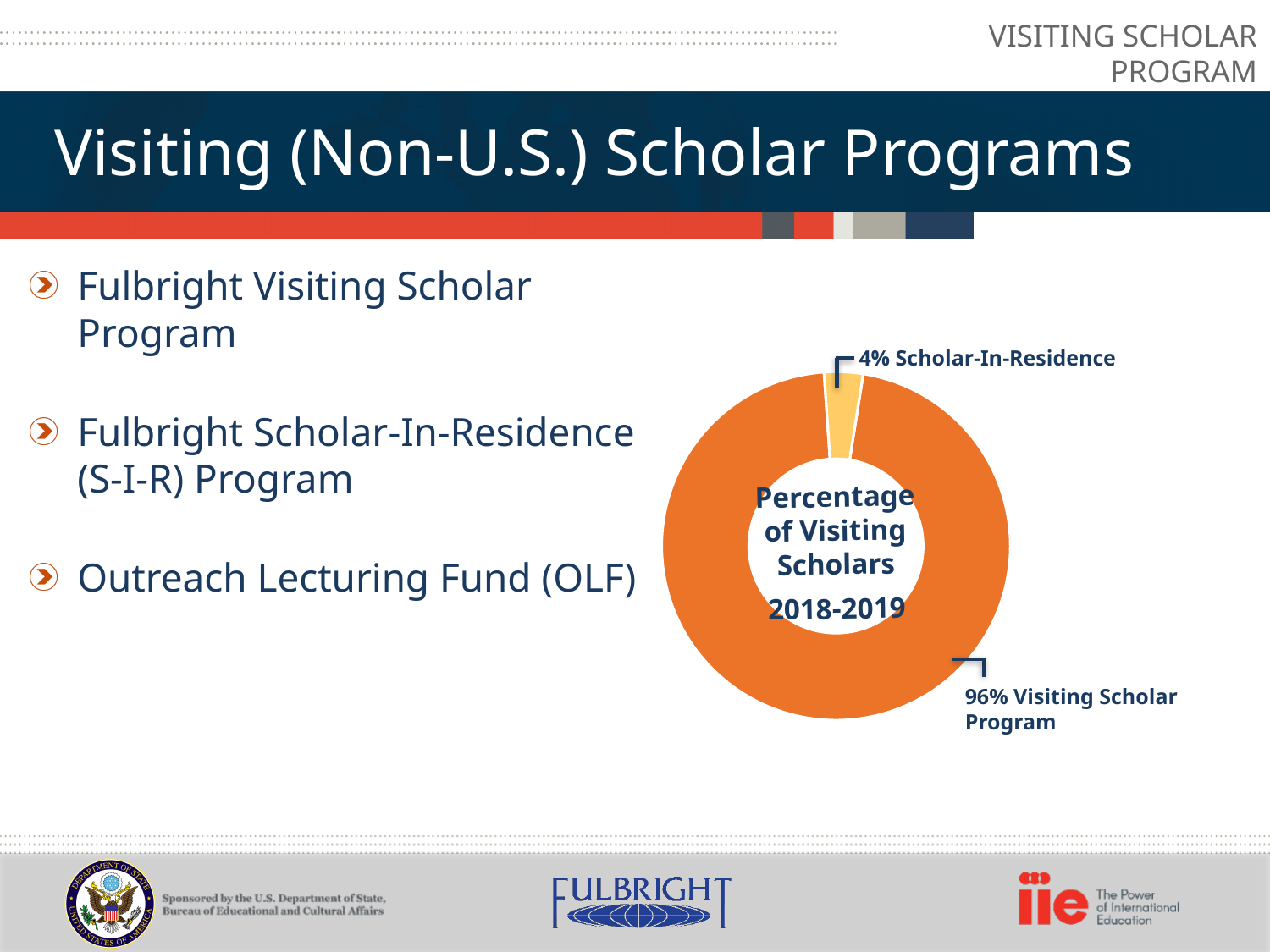
Which category has the largest share of the chart? Visiting Scholar Program What is the total of the two percentages shown in the chart? 100% Which category has the smallest share of the chart? Scholar-In-Residence What is the difference in percentage points between the Visiting Scholar Program and Scholar-In-Residence shares? 92 How many categories are shown in the chart? 2 What kind of chart is shown on the slide? Doughnut (pie) chart What percentage of visiting scholars were in the Visiting Scholar Program in 2018-2019? 96% What is the title shown in the centre of the chart? Percentage of Visiting Scholars 2018-2019 What colour is the Scholar-In-Residence slice? Light orange (yellow-orange) Which is larger: the Scholar-In-Residence share or the Visiting Scholar Program share? Visiting Scholar Program What percentage of visiting scholars were Scholar-In-Residence in 2018-2019? 4%